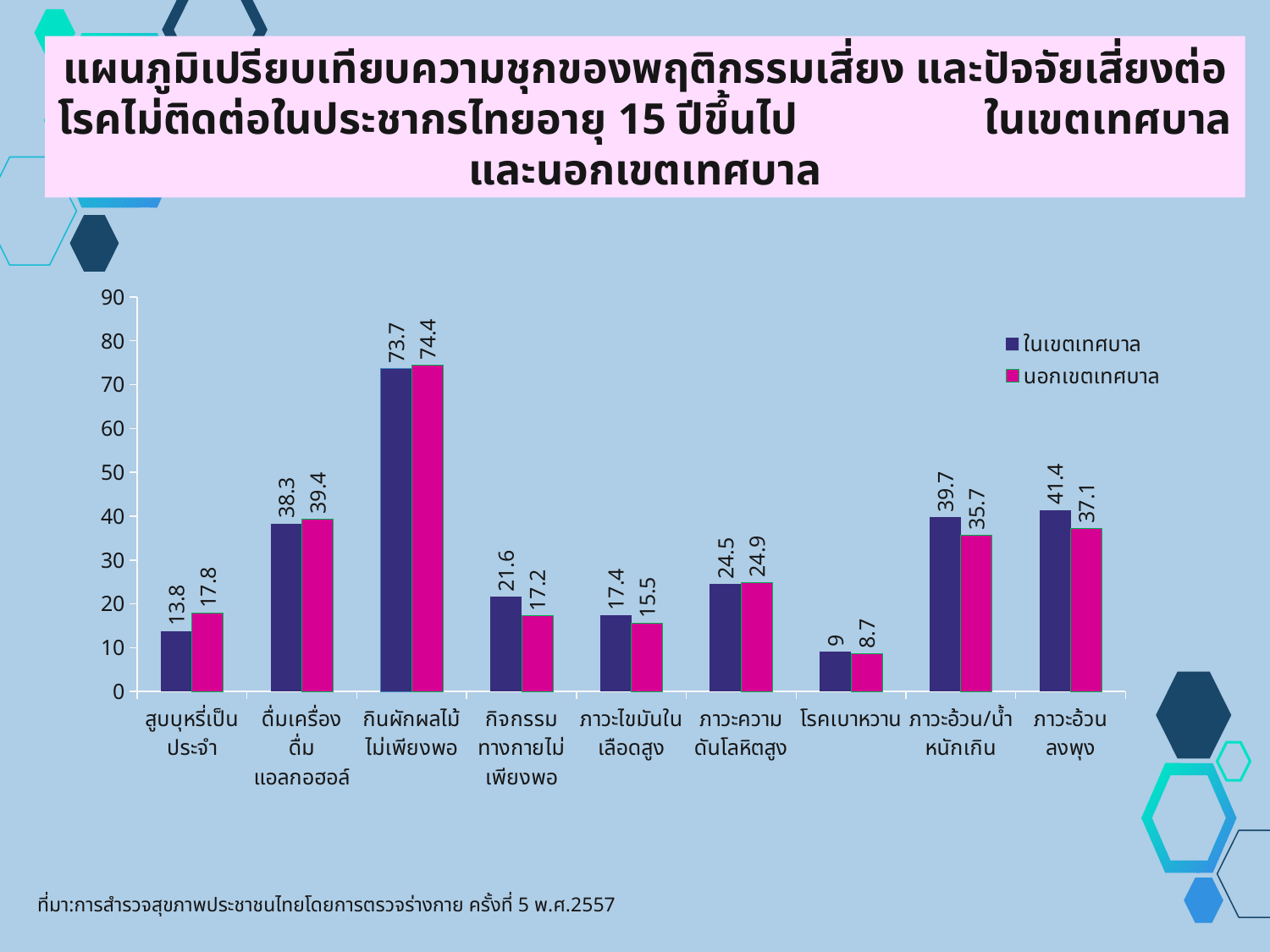
What is the value for นอกเขตเทศบาล in the category สูบบุหรี่เป็นประจำ? 17.8 Which category has the highest value for นอกเขตเทศบาล? กินผักผลไม้ไม่เพียงพอ How many series does the legend list? 2 In the category กิจกรรมทางกายไม่เพียงพอ, which series has the larger value, ในเขตเทศบาล or นอกเขตเทศบาล? ในเขตเทศบาล What is the difference between ในเขตเทศบาล and นอกเขตเทศบาล in the category ภาวะอ้วนลงพุง? 4.3 What is the value for ในเขตเทศบาล in the category โรคเบาหวาน? 9 What is the value for ในเขตเทศบาล in the category กินผักผลไม้ไม่เพียงพอ? 73.7 What colour are the bars for the series นอกเขตเทศบาล? magenta (pink) Which category has the lowest value for ในเขตเทศบาล? โรคเบาหวาน How many categories are shown on the x axis? 9 Is the value for นอกเขตเทศบาล in the category ภาวะอ้วน/น้ำหนักเกิน greater or less than 40? less What kind of chart is shown on the slide? bar chart